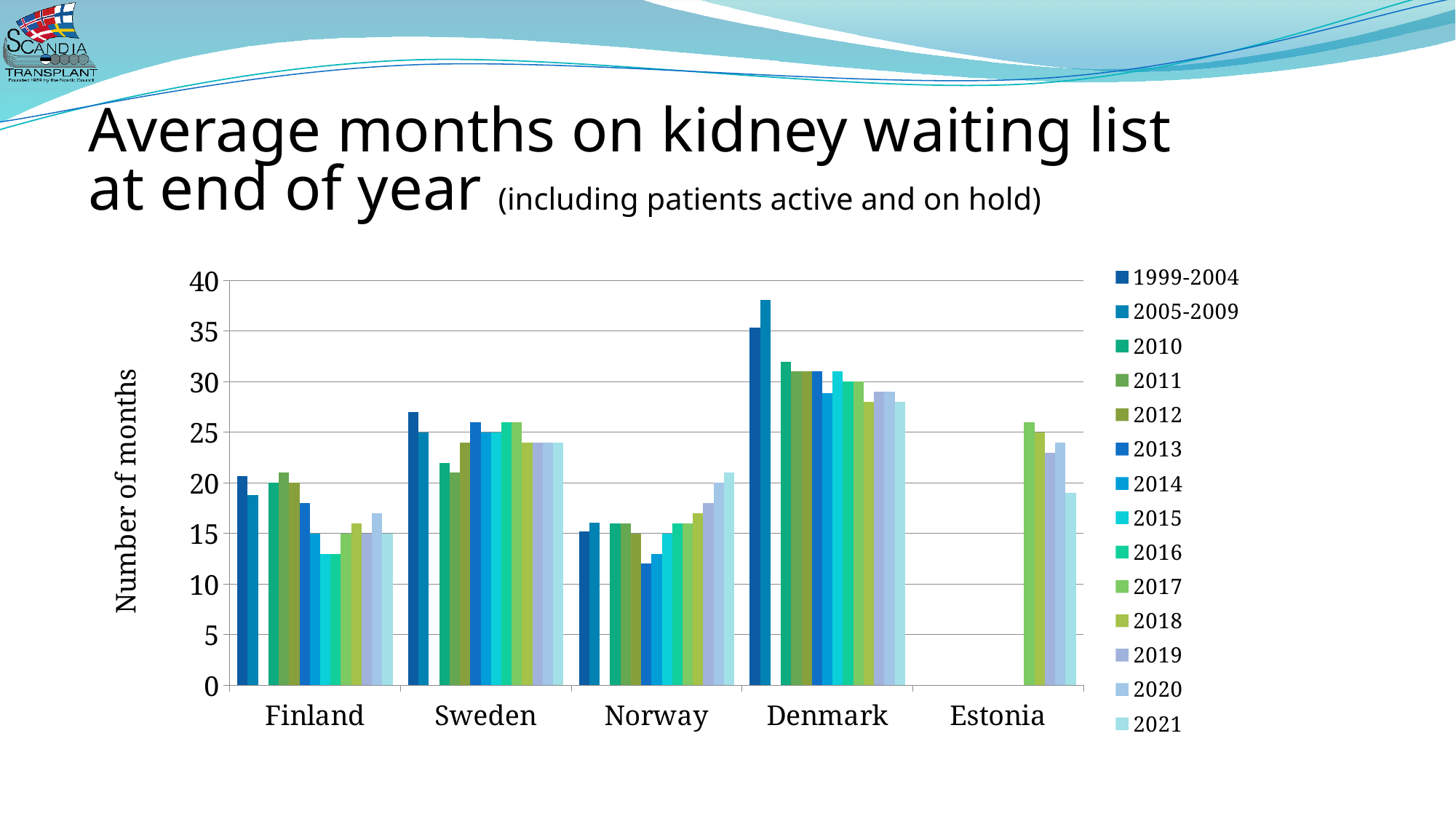
What is the label on the y axis? Number of months How many countries are shown on the x axis? 5 Is the value for Denmark in 2005-2009 greater or less than 35? greater What kind of chart is shown on the slide? bar chart How many series does the legend list? 14 Which is larger, the 2013 value for Finland or the 2013 value for Norway? Finland Is the value for Finland in 2016 greater or less than 15? less Is the value for Norway in 2021 greater or less than 20? greater Which country has the highest bar in the chart? Denmark Do the values for Norway rise or fall from 2013 to 2021? rise